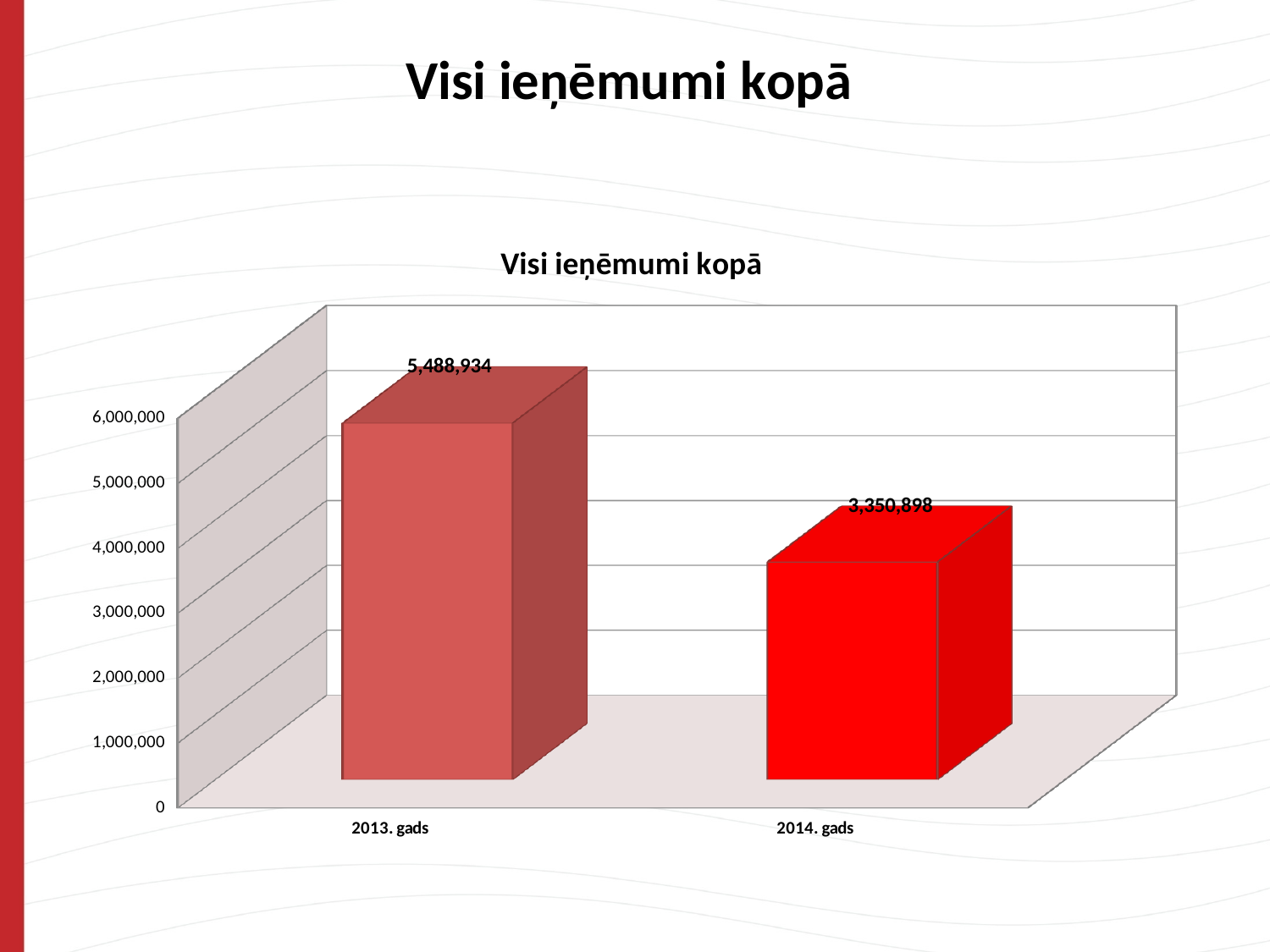
What is the title of the chart? Visi ieņēmumi kopā What is the difference between the values for 2013. gads and 2014. gads? 2,138,036 Do the values rise or fall from 2013. gads to 2014. gads? fall Is the value for 2013. gads greater or less than 5,000,000? greater How many categories are shown on the x axis? 2 Is the value for 2014. gads greater or less than 4,000,000? less Which year has the highest value? 2013. gads What is the value for 2013. gads? 5,488,934 Which is larger, the value for 2013. gads or for 2014. gads? 2013. gads What kind of chart is shown? bar chart Which year has the lowest value? 2014. gads What is the value for 2014. gads? 3,350,898